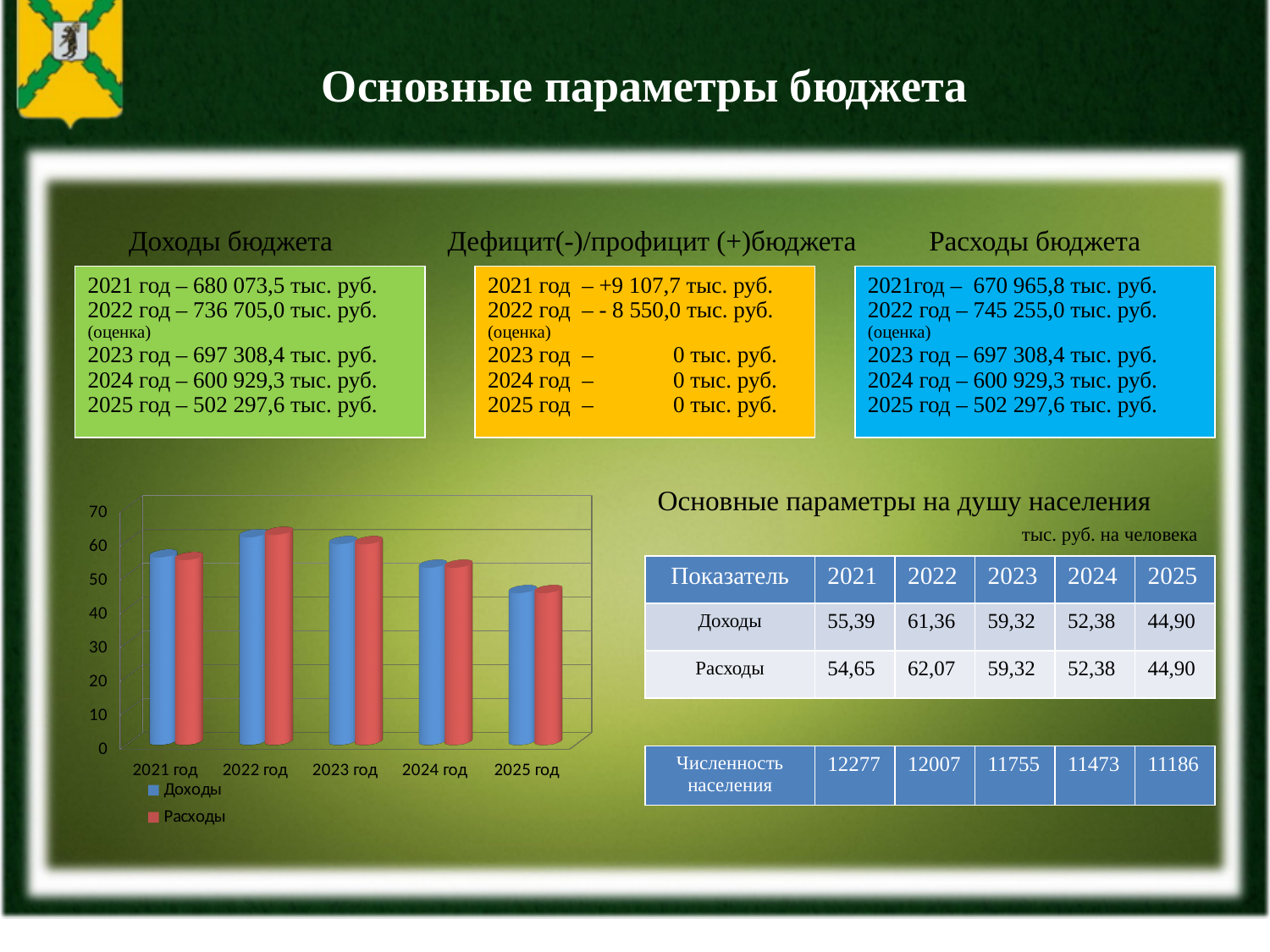
Which year has the lowest Доходы bar on the chart? 2025 год Which series is drawn in blue on the chart? Доходы Do the Расходы bars rise or fall from 2022 год to 2025 год? fall Is the Расходы value for 2025 год greater or less than 50? less Which is larger on the chart, the Доходы bar for 2021 год or for 2025 год? 2021 год How many year categories are shown on the chart's x axis? 5 Is the Расходы value for 2022 год greater or less than 60? greater Is the Доходы value for 2025 год greater or less than 40? greater What kind of chart is shown on the slide? bar chart How many series does the chart's legend list? 2 What are the two legend entries of the chart? Доходы, Расходы